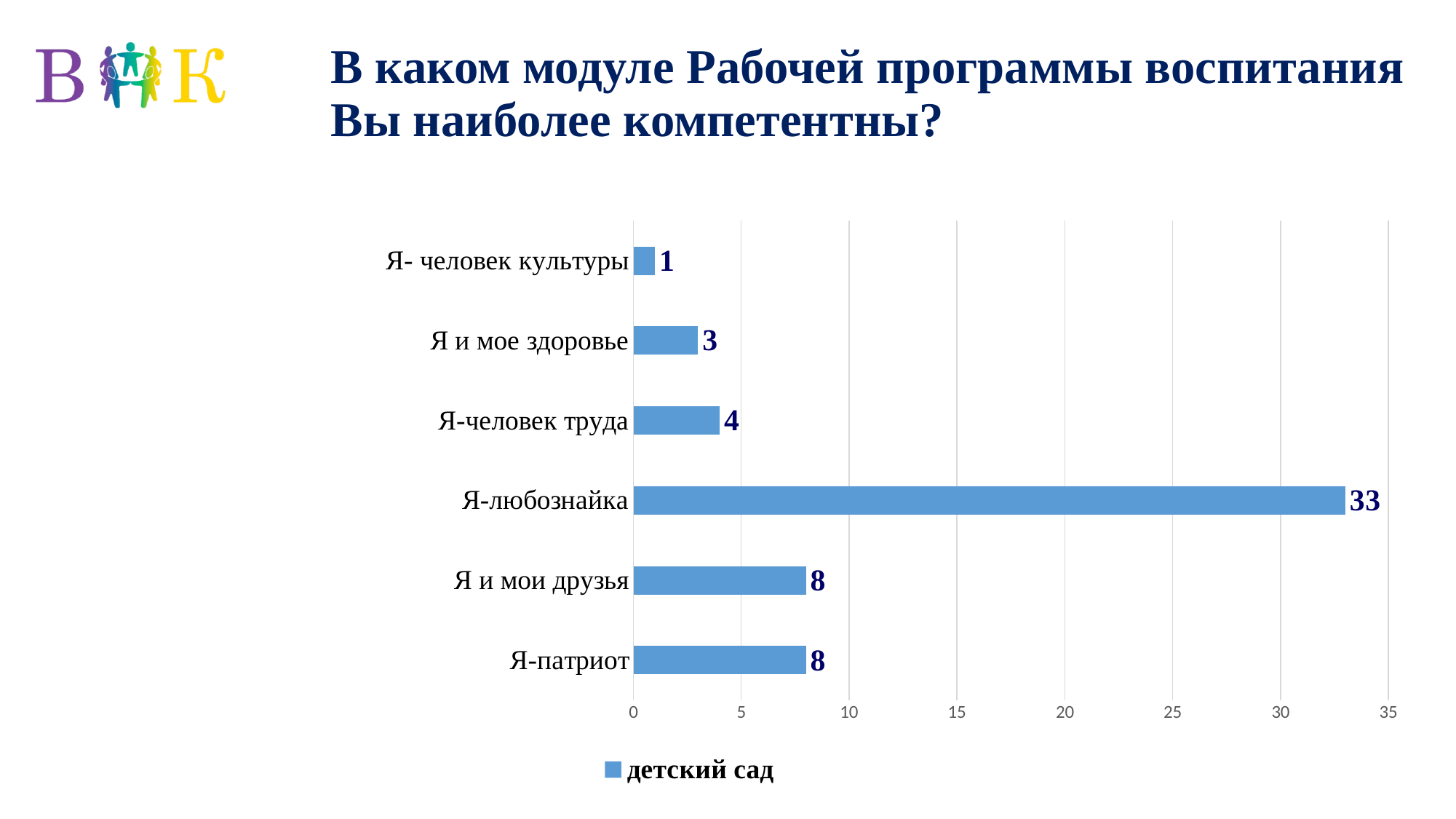
How many series does the legend list? 1 What is the value for Я-любознайка? 33 Which category has the highest value? Я-любознайка What is the difference between the values for Я-любознайка and Я и мои друзья? 25 Which category has the lowest value? Я- человек культуры What kind of chart is shown on the slide? bar chart Which is larger, the value for Я-человек труда or the value for Я и мое здоровье? Я-человек труда What is the value for Я и мое здоровье? 3 What is the value for Я-патриот? 8 Is the value for Я-любознайка greater or less than 30? greater What is the value for Я-человек труда? 4 How many categories are shown in the chart? 6